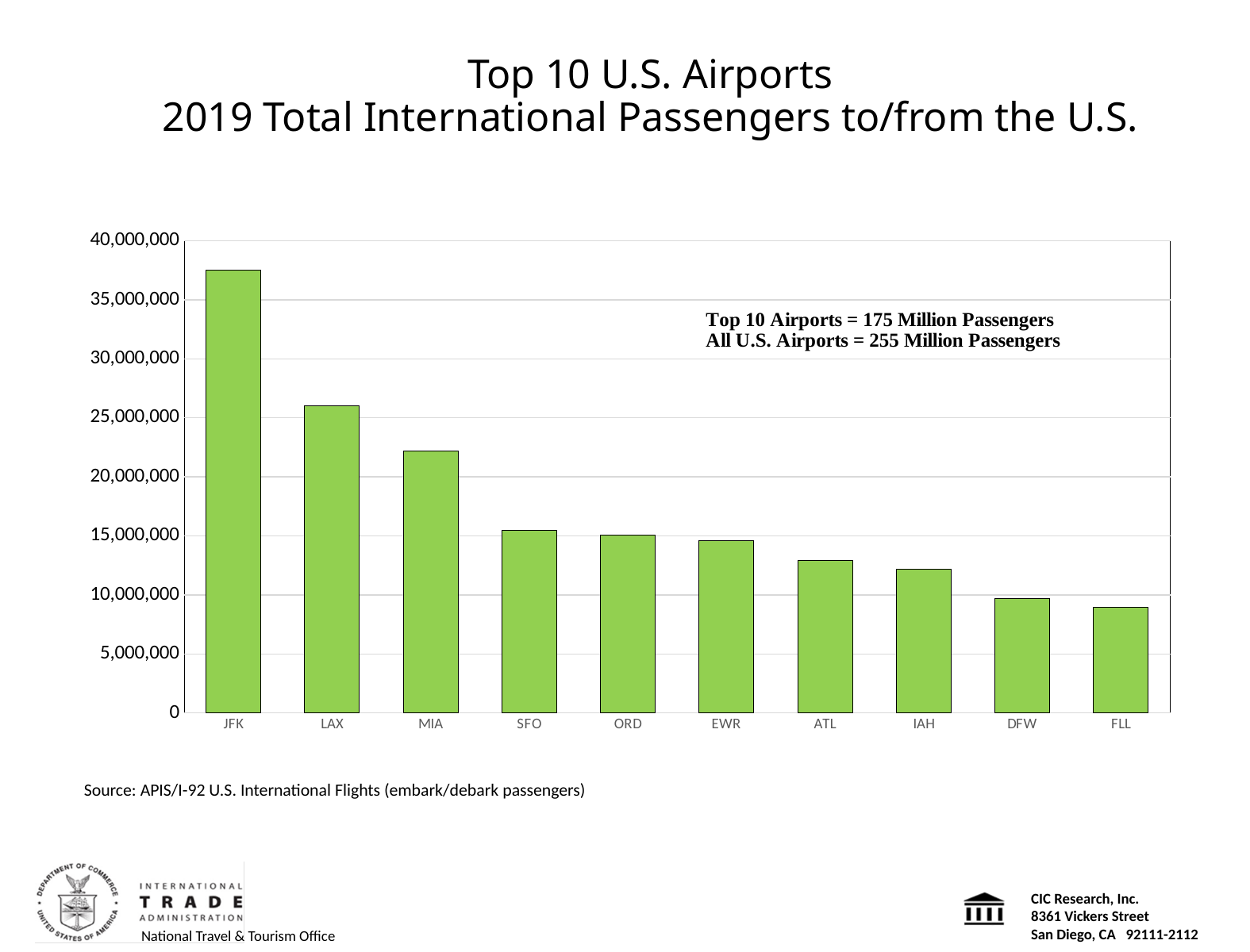
What kind of chart is shown on the slide? Bar chart Which has more international passengers, LAX or MIA? LAX Is the value for FLL greater or less than 10,000,000? less Which airport has the highest number of international passengers? JFK Is the value for JFK greater or less than 35,000,000? greater How many airports are shown on the chart? 10 Which airport has the lowest number of international passengers? FLL Is the value for ATL greater or less than 15,000,000? less According to the text on the chart, how many passengers did the top 10 airports account for? 175 Million Passengers According to the text on the chart, how many passengers did all U.S. airports account for? 255 Million Passengers Do the values rise or fall from left to right across the airports? Fall